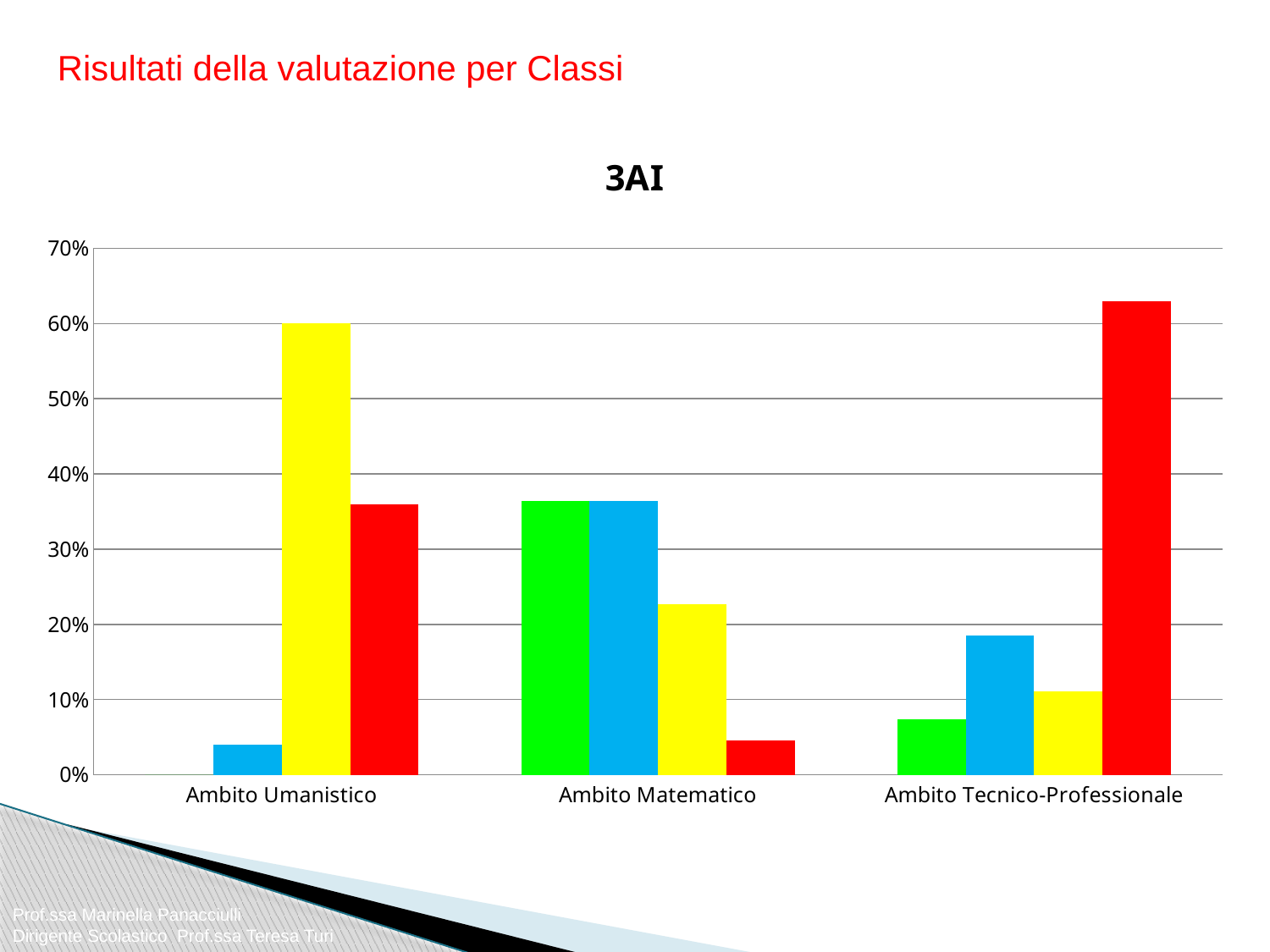
What kind of chart is shown on the slide? bar chart Which is larger: the red bar for Ambito Umanistico or the red bar for Ambito Matematico? Ambito Umanistico Is the value of the blue bar for Ambito Umanistico greater or less than 10%? less Is the value of the red bar for Ambito Tecnico-Professionale greater or less than 60%? greater How many categories are shown on the x axis of the chart? 3 What is the title of the chart? 3AI Which category has no green bar? Ambito Umanistico Is the value of the yellow bar for Ambito Matematico greater or less than 20%? greater In which category is the red bar the highest? Ambito Tecnico-Professionale In Ambito Matematico, which is larger: the yellow bar or the red bar? the yellow bar In Ambito Tecnico-Professionale, which coloured bar is the lowest? green What is the value of the yellow bar for Ambito Umanistico? 60%